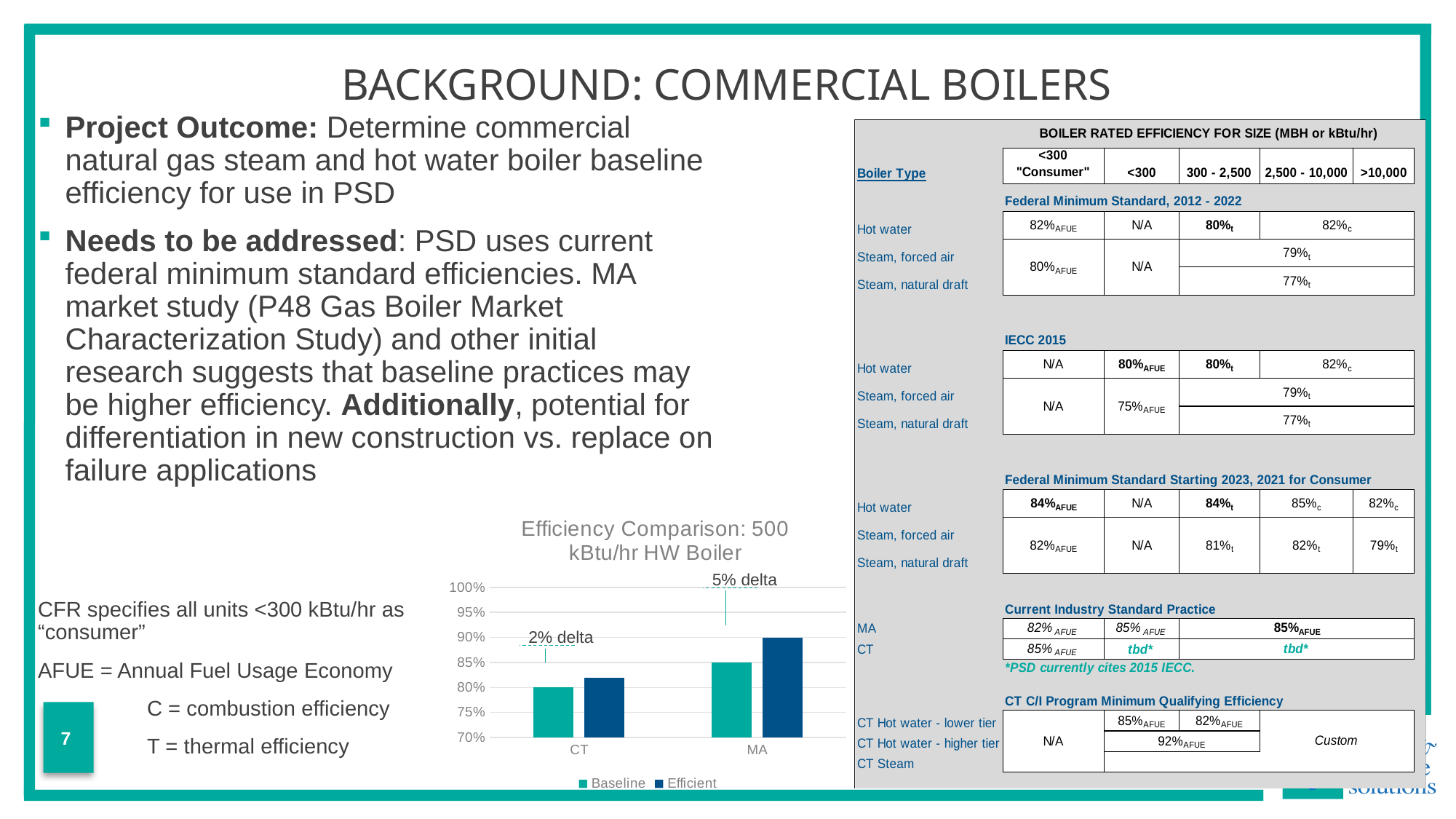
Which series in the efficiency comparison chart is shown in dark blue? Efficient What is the Baseline value for MA in the efficiency comparison chart? 85% How many series does the legend of the efficiency comparison chart list? 2 What is the Baseline value for CT in the efficiency comparison chart? 80% How many categories are shown on the x axis of the efficiency comparison chart? 2 What is the Efficient value for MA in the efficiency comparison chart? 90% What delta is annotated above the MA bars in the efficiency comparison chart? 5% delta Which category has the higher Baseline value in the efficiency comparison chart, CT or MA? MA Is the Efficient value for CT in the efficiency comparison chart greater or less than 80%? greater What kind of chart is the 'Efficiency Comparison: 500 kBtu/hr HW Boiler' chart? Bar chart What delta is annotated above the CT bars in the efficiency comparison chart? 2% delta What is the difference between the MA Baseline and CT Baseline values in the efficiency comparison chart? 5%